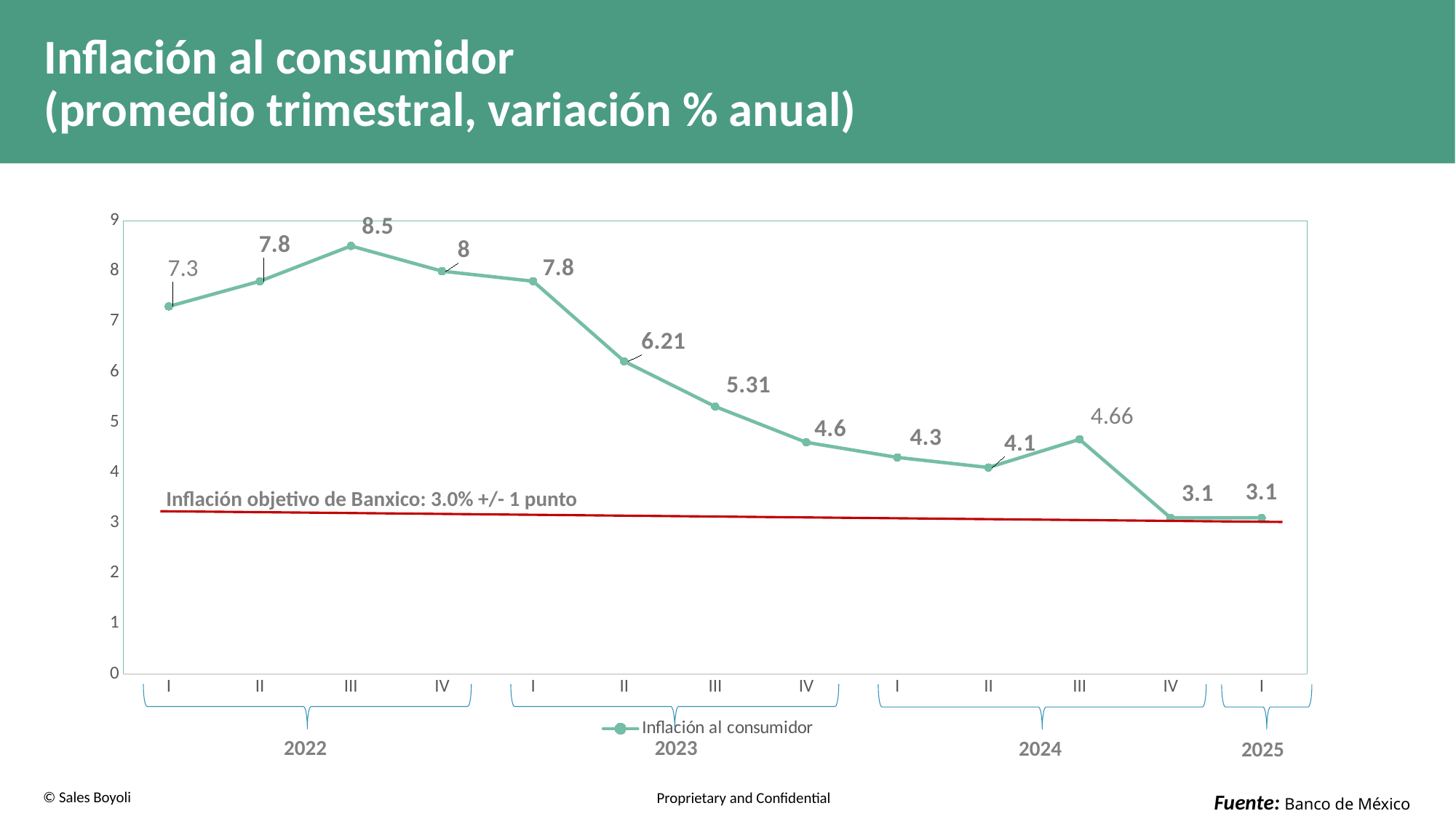
What is the value for quarter II of 2023? 6.21 Which quarter has the highest value? III 2022 Which is larger, the value for quarter IV of 2023 or quarter III of 2024? quarter III of 2024 How many quarterly data points are plotted on the chart? 13 What is the value for quarter III of 2024? 4.66 Do the values generally rise or fall from quarter I of 2023 to quarter I of 2025? fall How many series does the legend list? 1 What is the lowest value plotted on the chart? 3.1 Is the value for quarter I of 2024 greater or less than 5? less What type of chart is shown on the slide? line chart What is the difference between the value for quarter I of 2023 and quarter II of 2023? 1.59 What is the value for quarter III of 2022? 8.5